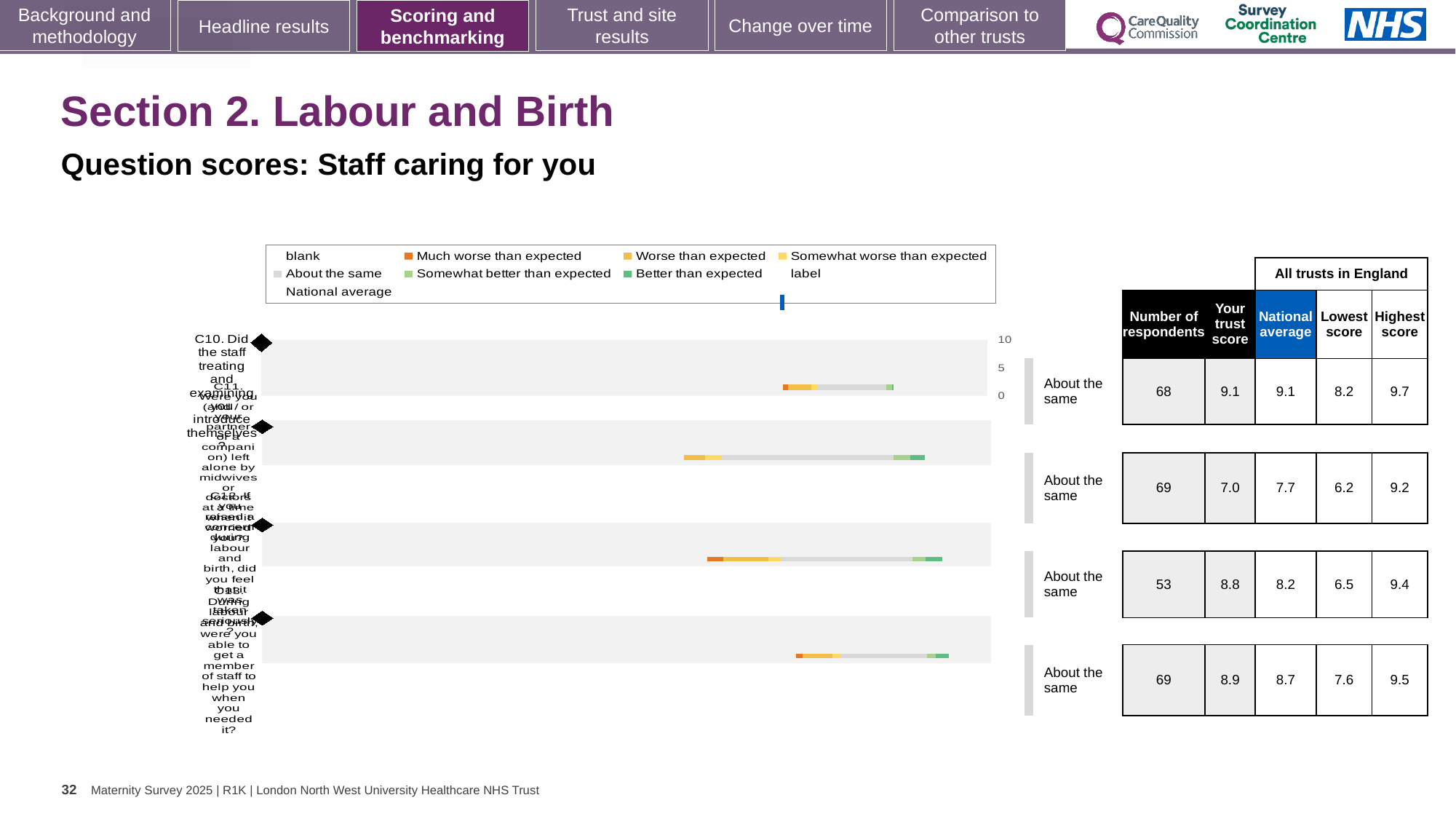
What benchmark label is shown next to every row of the chart? About the same In the table beside the chart, what is the lowest score for the first row? 8.2 In the chart legend, what colour represents 'About the same'? Grey In the table beside the chart, what is the highest score for the fourth row? 9.5 For the second row, which is larger: 'Your trust score' or the national average? National average Which row has the highest 'Your trust score'? The first row (9.1) What kind of chart is shown on the slide? Bar chart Which row has the lowest number of respondents? The third row (53) For the third row, what is the difference between 'Your trust score' and the national average? 0.6 How many question rows (bars) does the chart show? 4 In the table beside the chart, what is 'Your trust score' for the second row? 7.0 In the table beside the chart, what is the number of respondents for the first row? 68